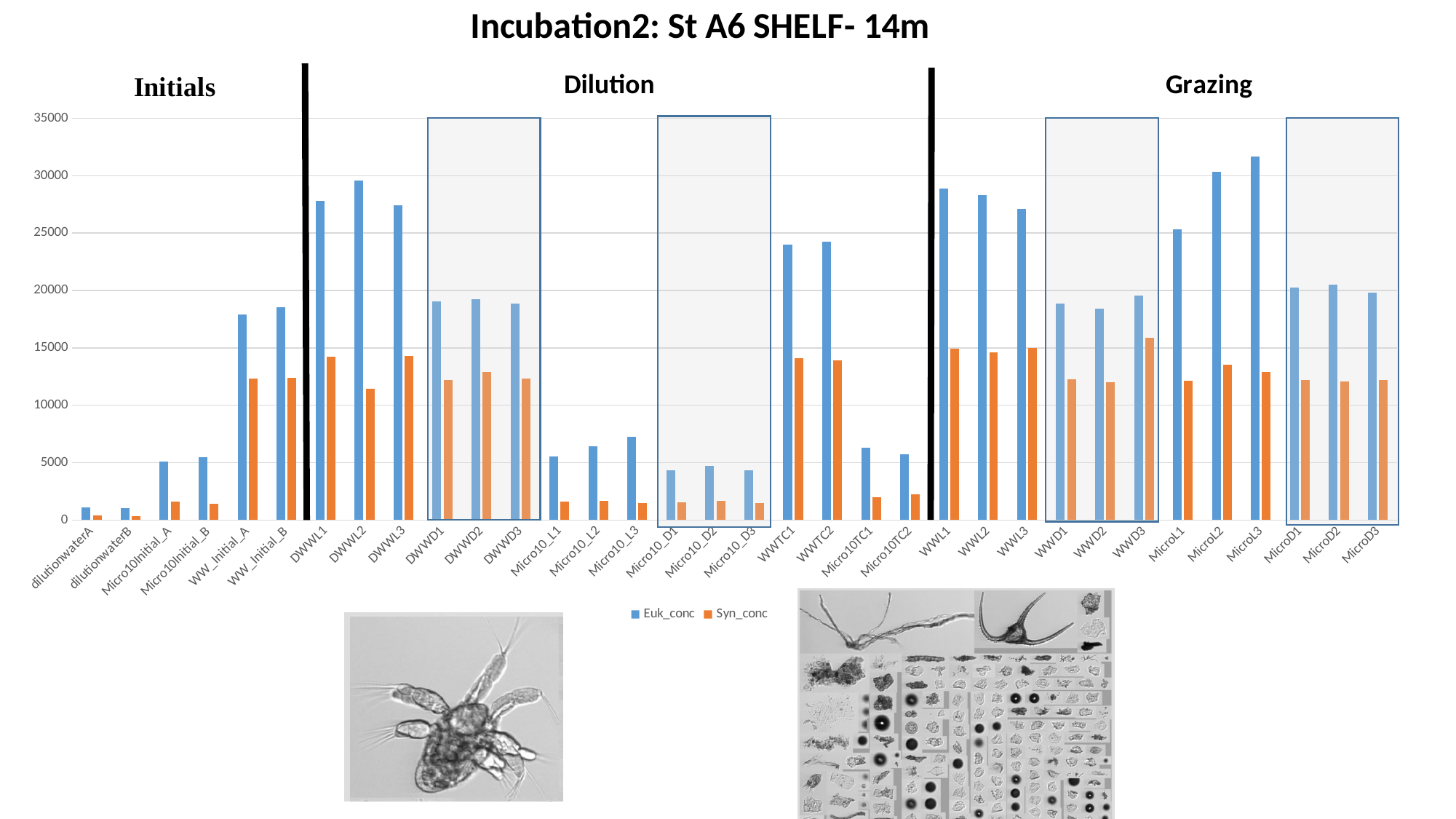
What is the title of the chart? Incubation2: St A6 SHELF- 14m Which has the larger Syn_conc value, Micro10_L1 or WWTC1? WWTC1 Is the Euk_conc value for Micro10_D1 greater or less than 5000? less Which series is shown in orange? Syn_conc Is the Syn_conc value for DWWL2 greater or less than 10000? greater Which category has the highest Euk_conc value? MicroL3 How many categories are plotted along the x axis? 34 Is the Euk_conc value for DWWL2 greater or less than 25000? greater Which category has the highest Syn_conc value? WWD3 How many series does the legend list? 2 What kind of chart is shown on the slide? bar chart Which has the larger Euk_conc value, DWWL1 or DWWD1? DWWL1